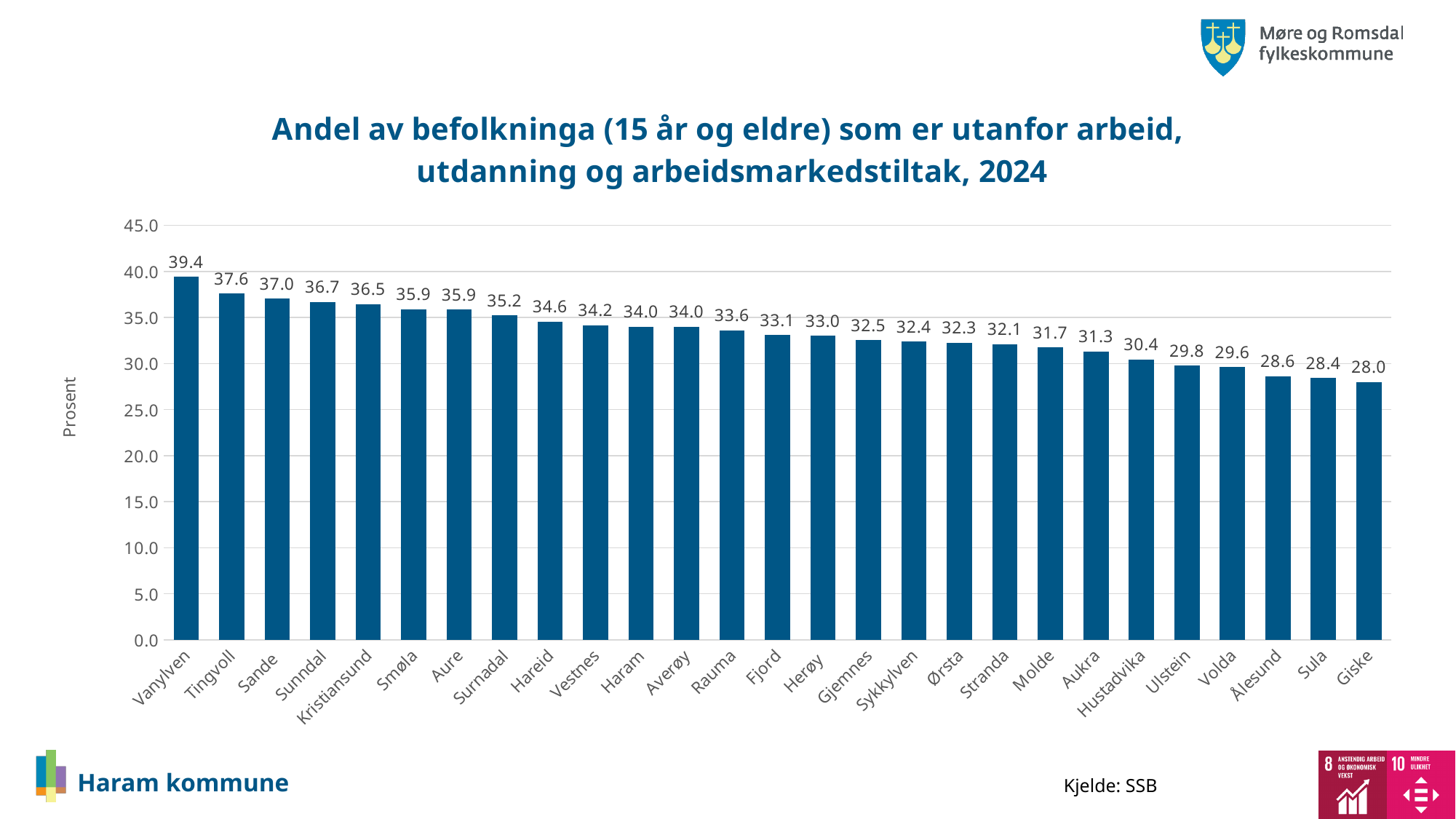
Is the value for Ulstein greater or less than 30.0? less Which municipality has the highest value? Vanylven What is the label of the vertical axis? Prosent What is the value for Molde? 31.7 What is the value for Haram? 34.0 What is the difference between the values for Tingvoll and Ålesund? 9.0 Which has a larger value, Sunndal or Hustadvika? Sunndal What is the difference between the values for Vanylven and Giske? 11.4 Which municipality has the lowest value? Giske What is the value for Kristiansund? 36.5 How many municipalities are shown on the chart? 27 What kind of chart is shown on the slide? bar chart